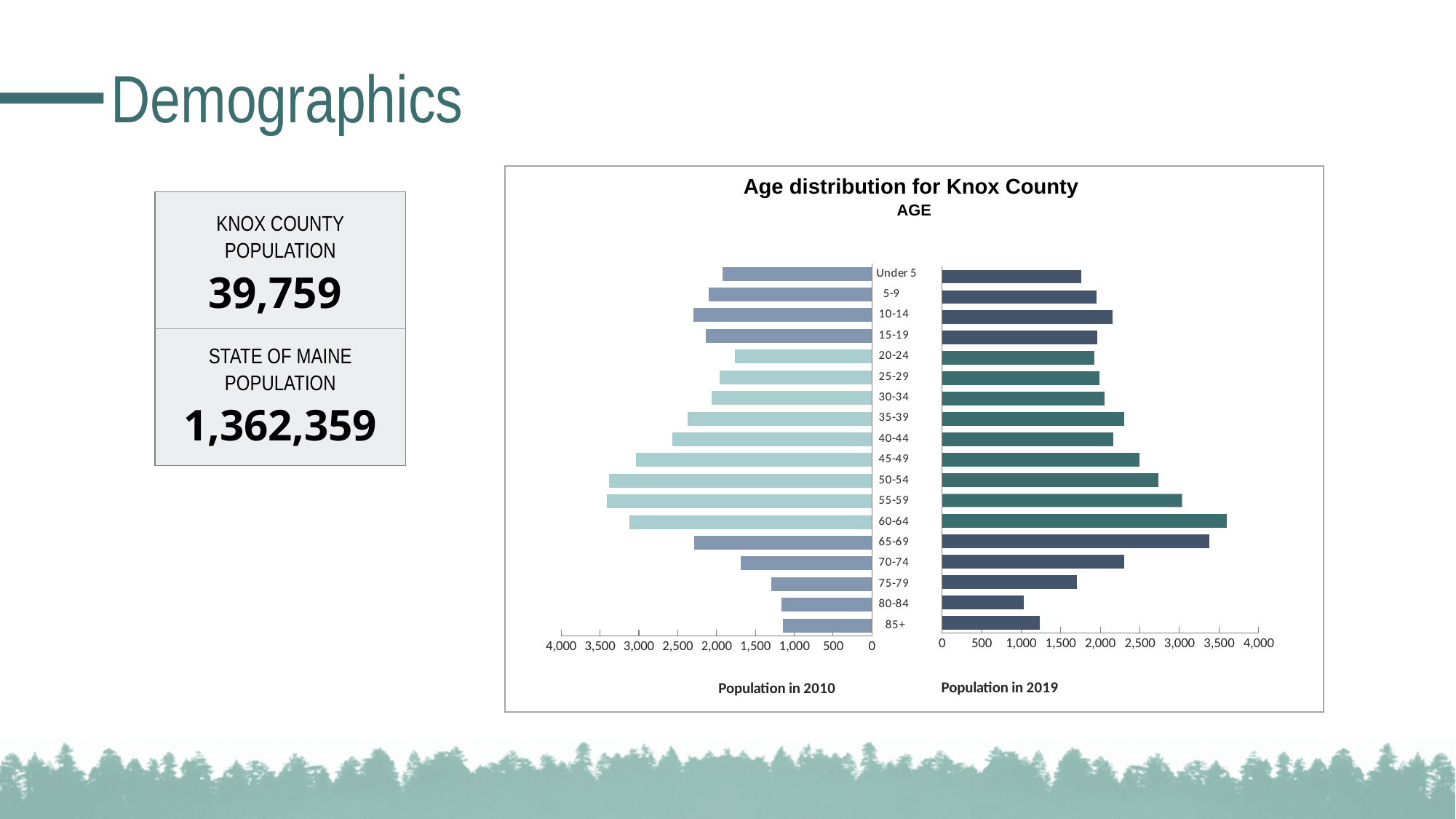
What kind of chart is used to show the age distribution for Knox County? Bar chart Which population year is shown on the left side of the Age distribution for Knox County chart? Population in 2010 Is the Population in 2010 value for the 55-59 age group greater or less than 3,000? greater In the Population in 2019 side of the chart, which age group has the larger population: 60-64 or Under 5? 60-64 In the Population in 2019 side of the chart, which age group has the highest population? 60-64 How many age groups are shown in the Age distribution for Knox County chart? 18 Is the Population in 2010 value for the 20-24 age group greater or less than 2,000? less In the Population in 2010 side of the chart, which age group has the larger population: 10-14 or 20-24? 10-14 How many population years (series) does the Age distribution for Knox County chart show? 2 Is the Population in 2019 value for the 80-84 age group greater or less than 1,500? less In the Population in 2019 side of the chart, which age group has the lowest population? 80-84